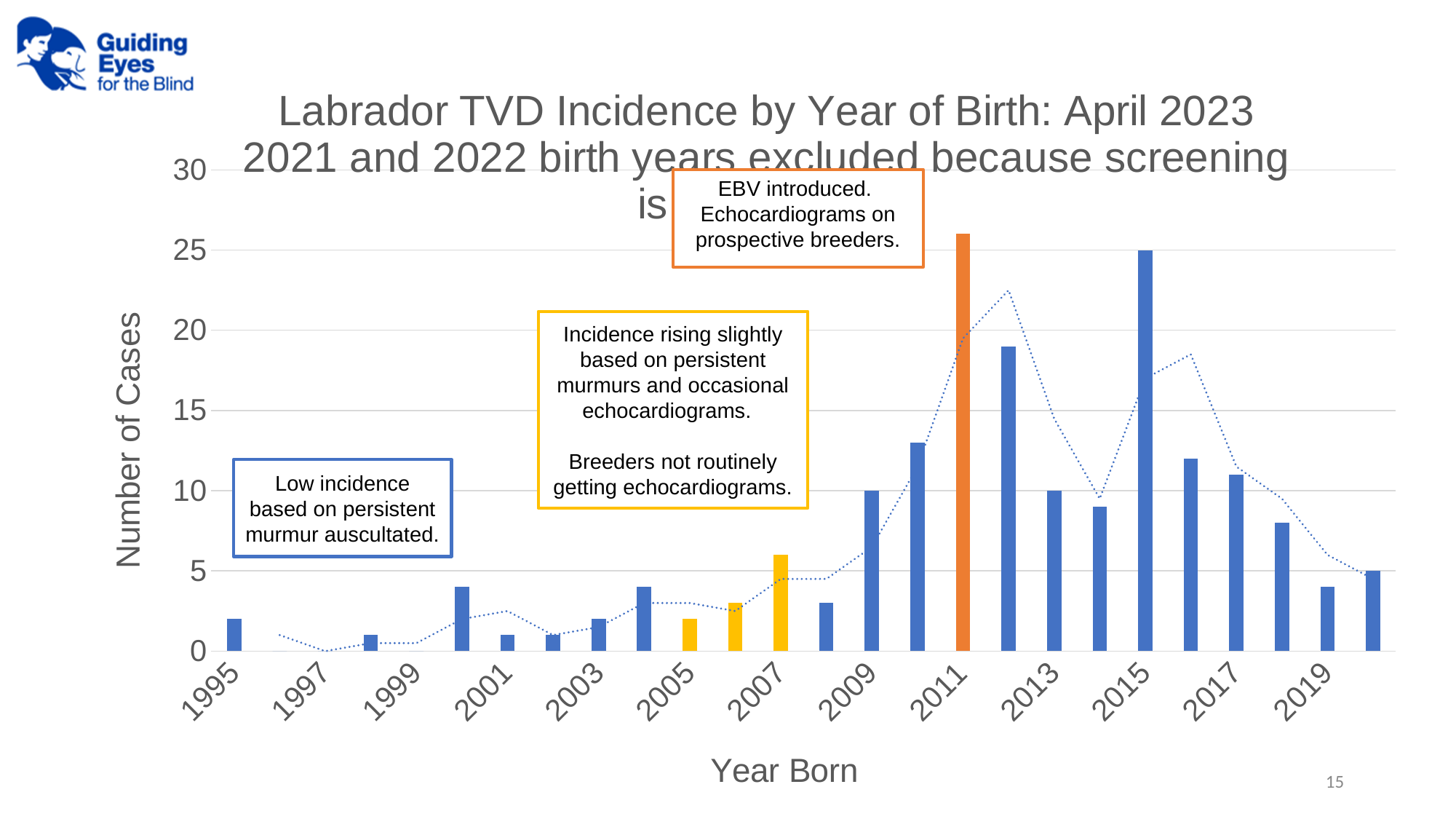
What is the title of the x axis? Year Born Which has the larger value, 2016 or 2018? 2016 What is the title of the y axis? Number of Cases Is the value for 2007 greater or less than 5? greater Is the value for 2019 greater or less than 5? less Is the value for 2010 greater or less than 10? greater Do the values rise or fall from 2015 to 2019? fall Which has the larger value, 2012 or 2013? 2012 What kind of chart is shown on the slide? bar chart